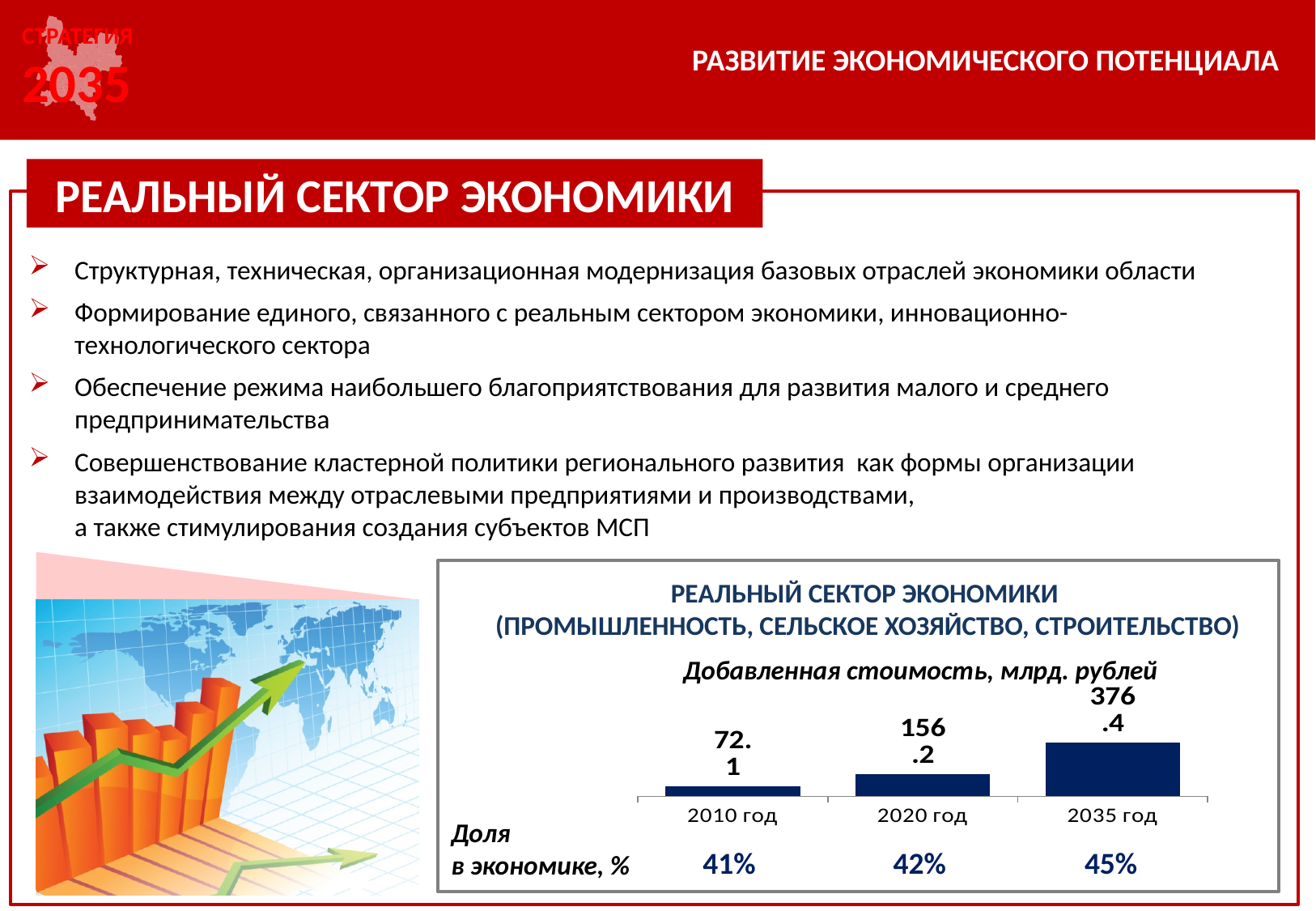
In the chart 'Добавленная стоимость, млрд. рублей', what is the difference between the values for 2035 год and 2020 год? 220.2 What is the value for 2020 год in the chart 'Добавленная стоимость, млрд. рублей'? 156.2 What is the unit stated in the title of the chart 'Добавленная стоимость, млрд. рублей'? млрд. рублей Which year has the lowest value in the chart 'Добавленная стоимость, млрд. рублей'? 2010 год Do the values in the chart 'Добавленная стоимость, млрд. рублей' rise or fall from 2010 год to 2035 год? rise What type of chart is 'Добавленная стоимость, млрд. рублей'? bar chart Which year has the highest value in the chart 'Добавленная стоимость, млрд. рублей'? 2035 год In the chart 'Добавленная стоимость, млрд. рублей', which is larger: the value for 2020 год or for 2010 год? 2020 год What is the value for 2035 год in the chart 'Добавленная стоимость, млрд. рублей'? 376.4 What is the value for 2010 год in the chart 'Добавленная стоимость, млрд. рублей'? 72.1 How many years (categories) are shown in the chart 'Добавленная стоимость, млрд. рублей'? 3 In the chart 'Добавленная стоимость, млрд. рублей', what is the difference between the values for 2020 год and 2010 год? 84.1